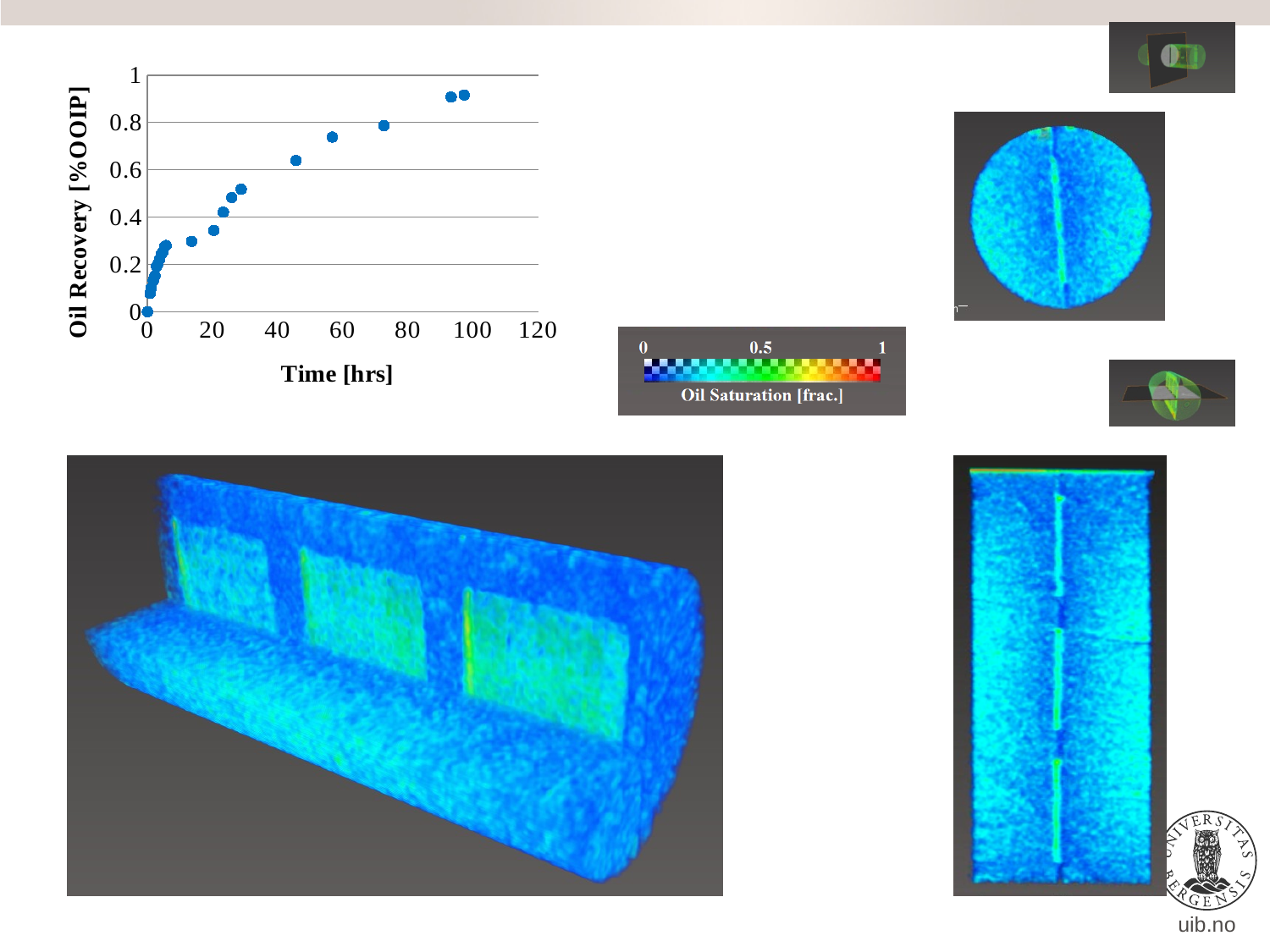
Is the oil recovery at around 45 hours greater or less than 0.6? greater Is the oil recovery at around 20 hours greater or less than 0.4? less Does any point on the chart reach an oil recovery of 1? No What is the label of the y axis of the chart? Oil Recovery [%OOIP] What kind of chart is shown on the slide? scatter chart At what time is the lowest oil recovery value plotted? 0 hrs What is the label of the x axis of the chart? Time [hrs] Do the oil recovery values rise or fall as time increases along the x axis? rise Which is higher, the oil recovery at around 100 hours or at around 20 hours? around 100 hours